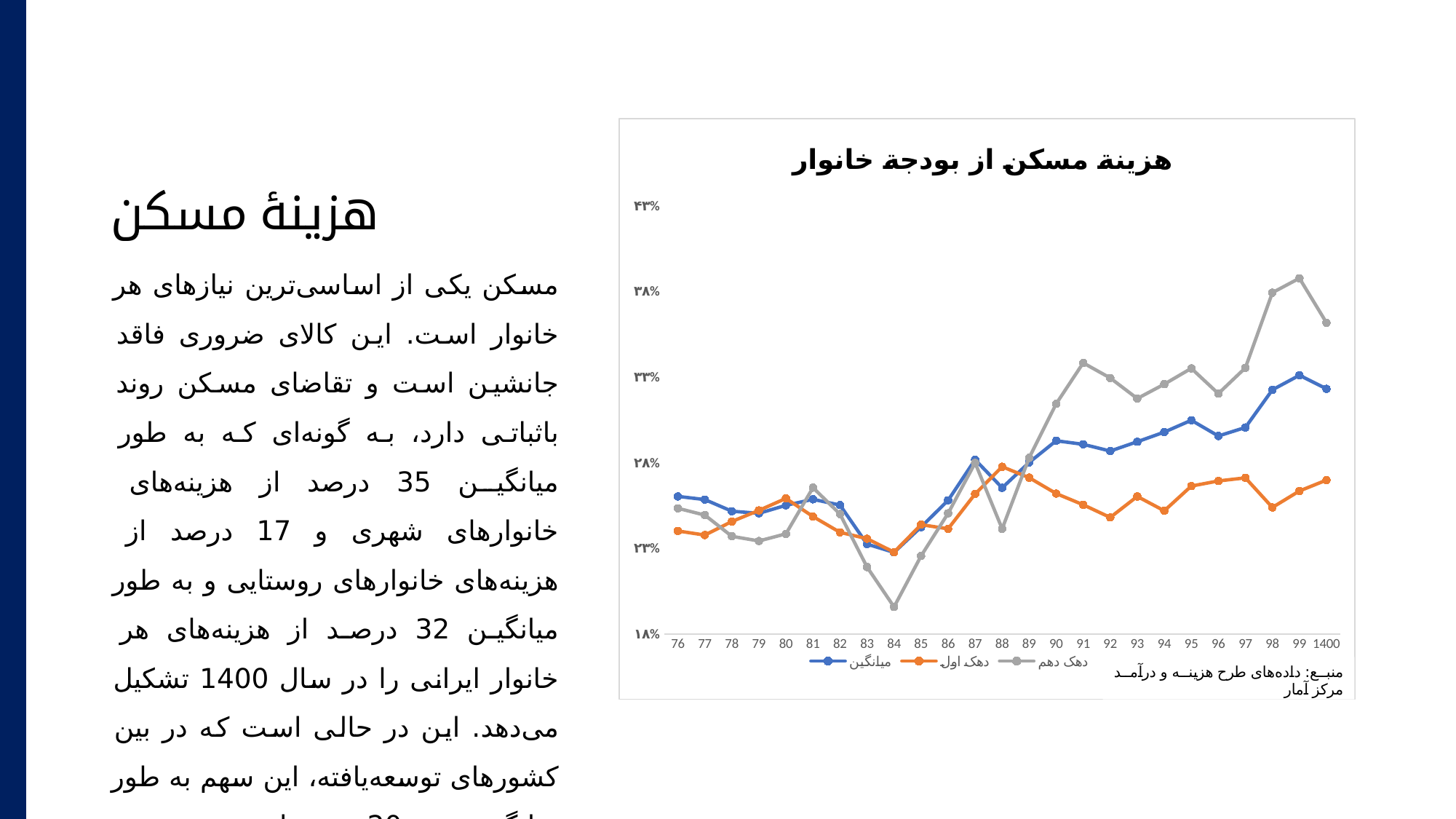
How many series does the legend of the chart list? 3 Which series are listed in the chart's legend? میانگین, دهک اول, دهک دهم Is the value for دهک اول in year 1400 greater or less than 28%? less Is the value for میانگین in year 76 greater or less than 23%? greater What kind of chart is shown on the slide? line chart In which year does the دهک دهم series reach its highest value? 99 Is the value for دهک دهم in year 99 greater or less than 33%? greater In which year does the دهک دهم series reach its lowest value? 84 How many years are plotted along the x axis of the chart? 25 What is the title of the chart? هزینۀ مسکن از بودجۀ خانوار In year 1400, which series has the higher value, دهک دهم or دهک اول? دهک دهم